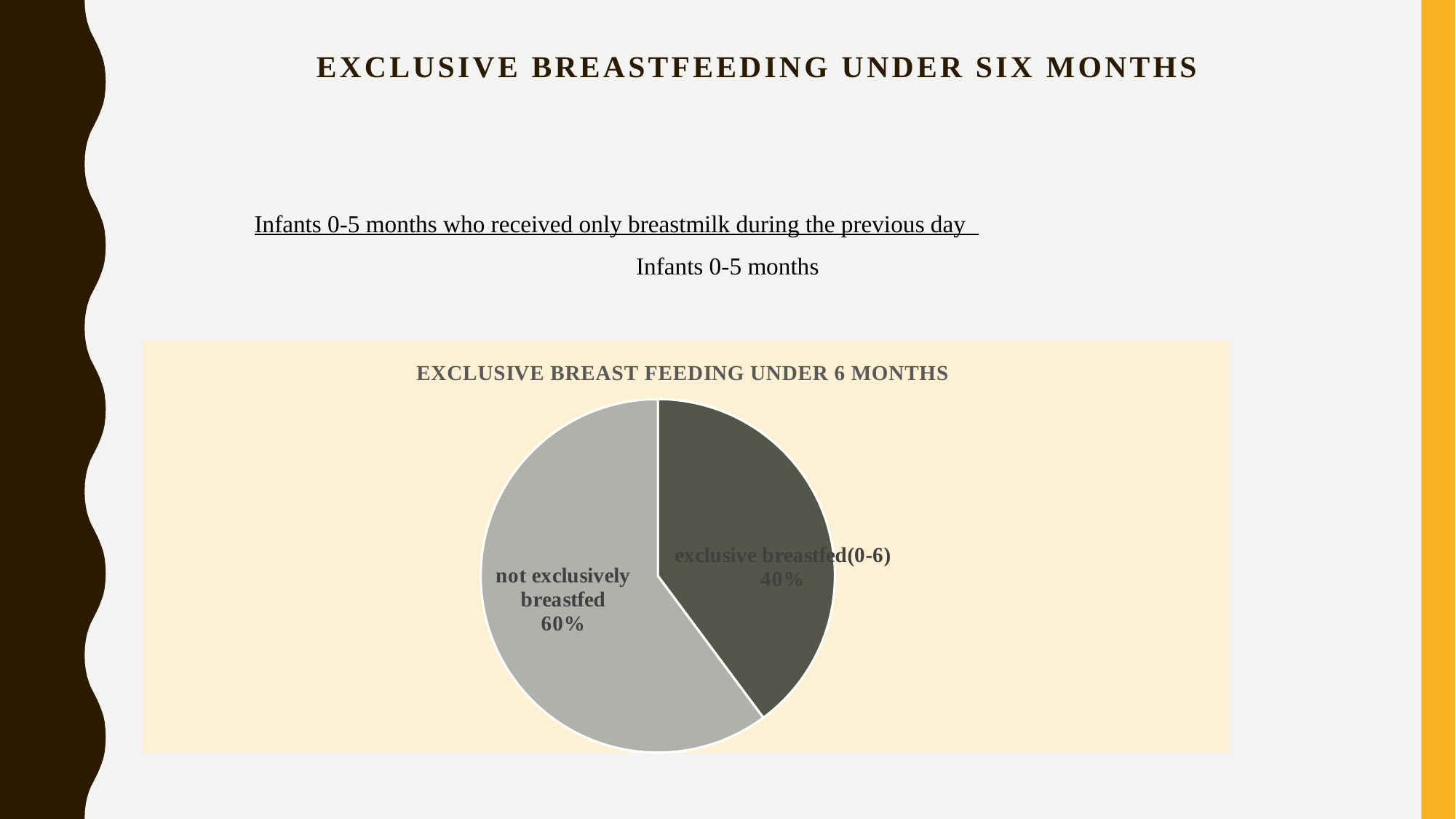
Which is larger: the "exclusive breastfed(0-6)" slice or the "not exclusively breastfed" slice? not exclusively breastfed What is the difference in percentage points between the "not exclusively breastfed" slice and the "exclusive breastfed(0-6)" slice? 20% Is the share for "exclusive breastfed(0-6)" greater or less than 50%? less What is the title of the chart? EXCLUSIVE BREAST FEEDING UNDER 6 MONTHS What share of the pie is labelled "exclusive breastfed(0-6)"? 40% What colour is the "not exclusively breastfed" slice? light grey Which slice of the pie is the largest? not exclusively breastfed What kind of chart is shown on the slide? pie chart Which slice of the pie is the smallest? exclusive breastfed(0-6) How many slices does the pie chart have? 2 What share of the pie is labelled "not exclusively breastfed"? 60%